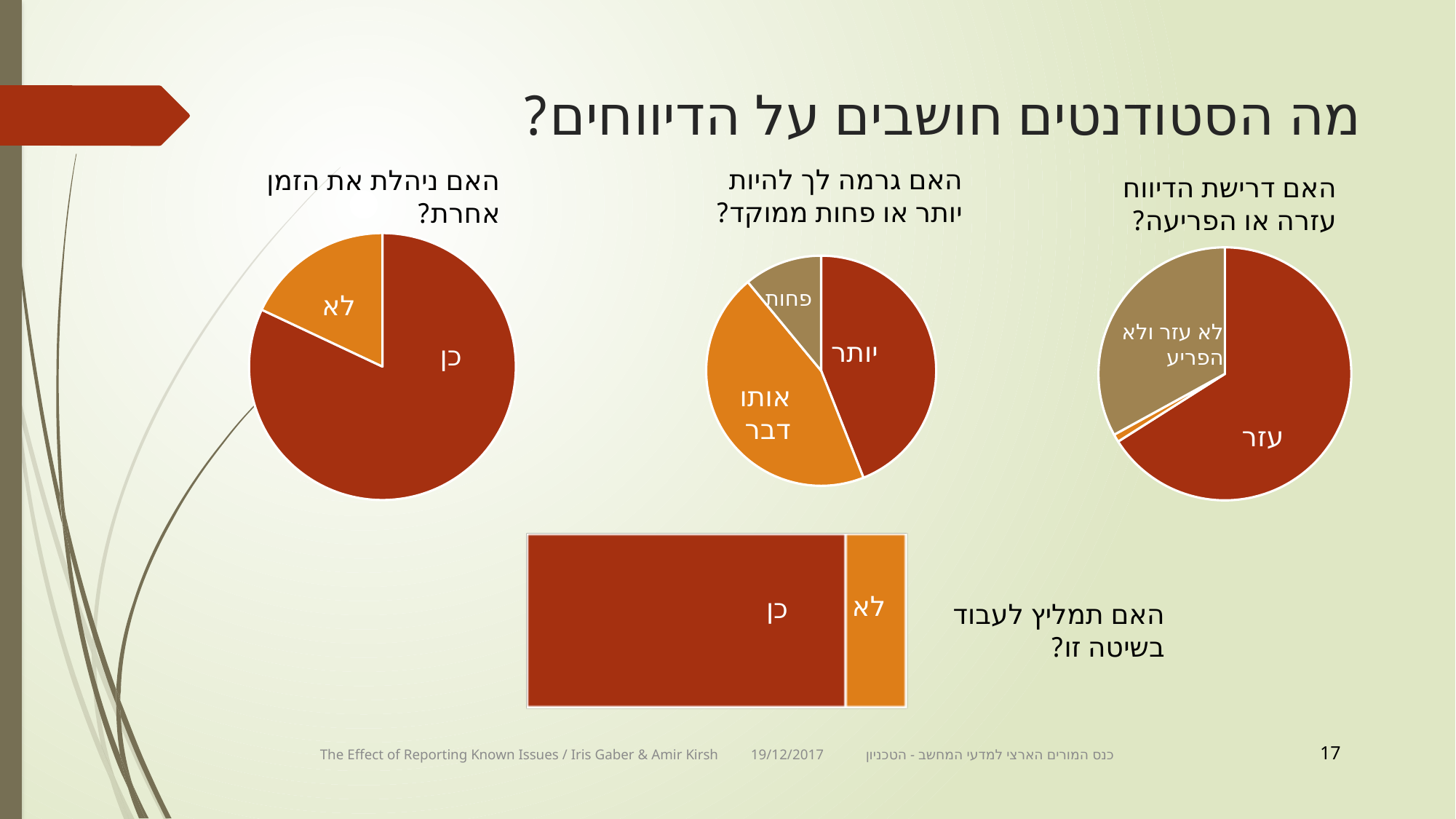
How many pie charts are shown on the slide? 3 In the pie chart titled "האם ניהלת את הזמן אחרת?", which slice is the largest? כן In the pie chart titled "האם גרמה לך להיות יותר או פחות ממוקד?", how many slices are there? 3 In the pie chart titled "האם דרישת הדיווח עזרה או הפריעה?", which slice is larger, "עזר" or "לא עזר ולא הפריע"? עזר In the chart titled "האם תמליץ לעבוד בשיטה זו?", which segment is larger, "כן" or "לא"? כן In the pie chart titled "האם גרמה לך להיות יותר או פחות ממוקד?", which slice is larger, "יותר" or "פחות"? יותר In the pie chart titled "האם דרישת הדיווח עזרה או הפריעה?", which slice is the largest? עזר In the pie chart titled "האם גרמה לך להיות יותר או פחות ממוקד?", which slice is the smallest? פחות In the chart titled "האם תמליץ לעבוד בשיטה זו?", how many segments does the bar have? 2 In the pie chart titled "האם ניהלת את הזמן אחרת?", how many slices are there? 2 What kind of chart is the one titled "האם תמליץ לעבוד בשיטה זו?"? bar chart What kind of chart is the one titled "האם ניהלת את הזמן אחרת?"? pie chart